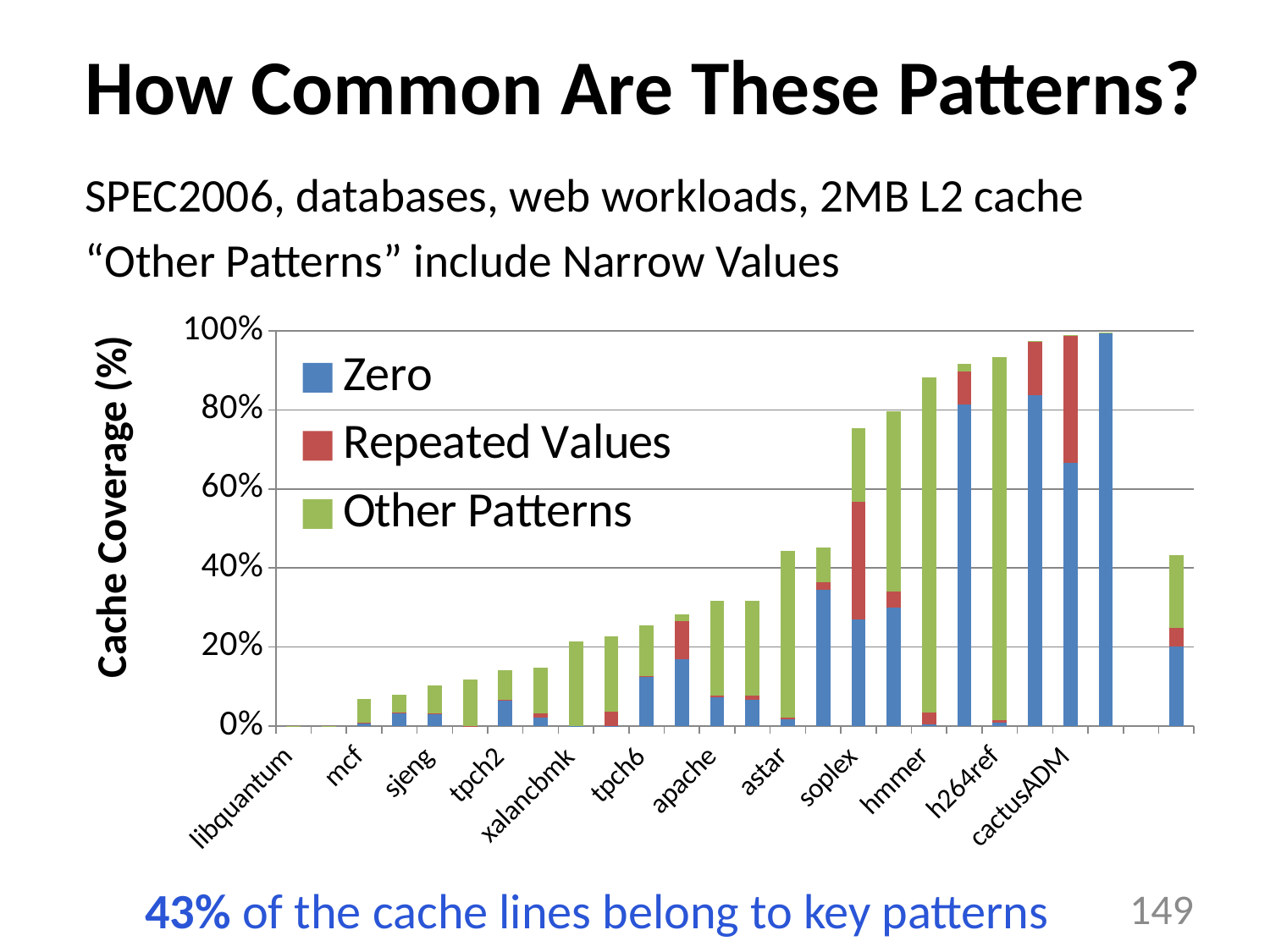
Do the total stacked values generally rise or fall along the x axis from libquantum to cactusADM? rise What is the label on the chart's vertical axis? Cache Coverage (%) What are the three series named in the chart's legend? Zero, Repeated Values, Other Patterns Which of the labeled categories has the lowest total stacked value? libquantum Is the total stacked value for cactusADM greater or less than 80%? greater How many series does the chart's legend list? 3 What kind of chart is shown on the slide? stacked bar chart Is the total stacked value for mcf greater or less than 20%? less Is the total stacked value for apache greater or less than 40%? less Which has the larger total stacked value, soplex or apache? soplex